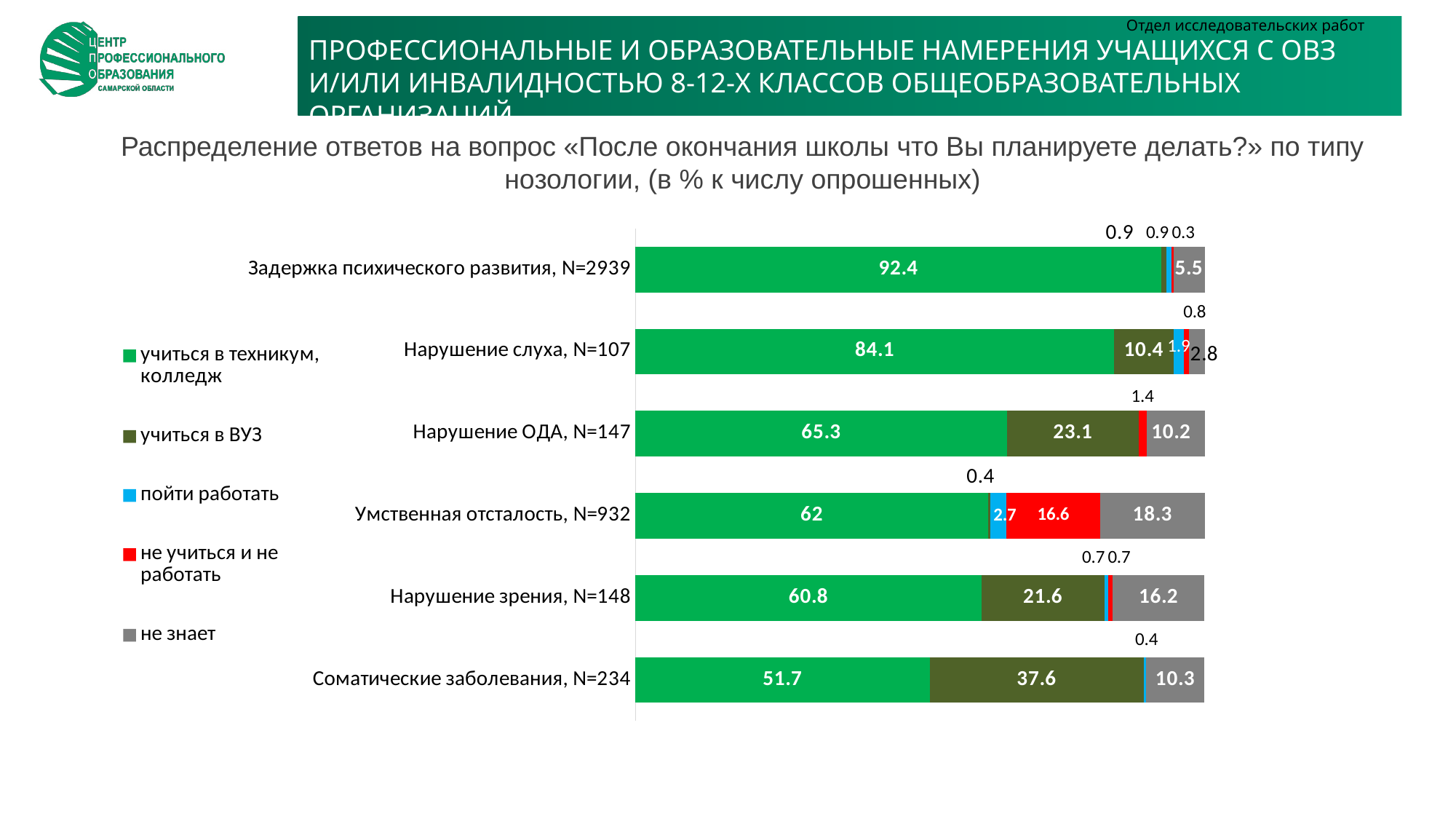
How many nosology categories are plotted on the chart? 6 What is the value for «учиться в ВУЗ» for «Соматические заболевания, N=234»? 37.6 What kind of chart is shown on the slide? Stacked bar chart Which colour represents the series «пойти работать» in the legend? Blue Which category has the lowest value for «учиться в техникум, колледж»? Соматические заболевания, N=234 How many series does the legend list? 5 Which is larger: the «не знает» value for «Умственная отсталость, N=932» or for «Нарушение зрения, N=148»? Умственная отсталость, N=932 What is the difference between the «учиться в ВУЗ» values for «Нарушение ОДА, N=147» and «Нарушение зрения, N=148»? 1.5 What is the value for «учиться в техникум, колледж» for «Задержка психического развития, N=2939»? 92.4 Which category has the highest value for «учиться в техникум, колледж»? Задержка психического развития, N=2939 What is the value for «не знает» for «Нарушение ОДА, N=147»? 10.2 What is the value for «не учиться и не работать» for «Умственная отсталость, N=932»? 16.6